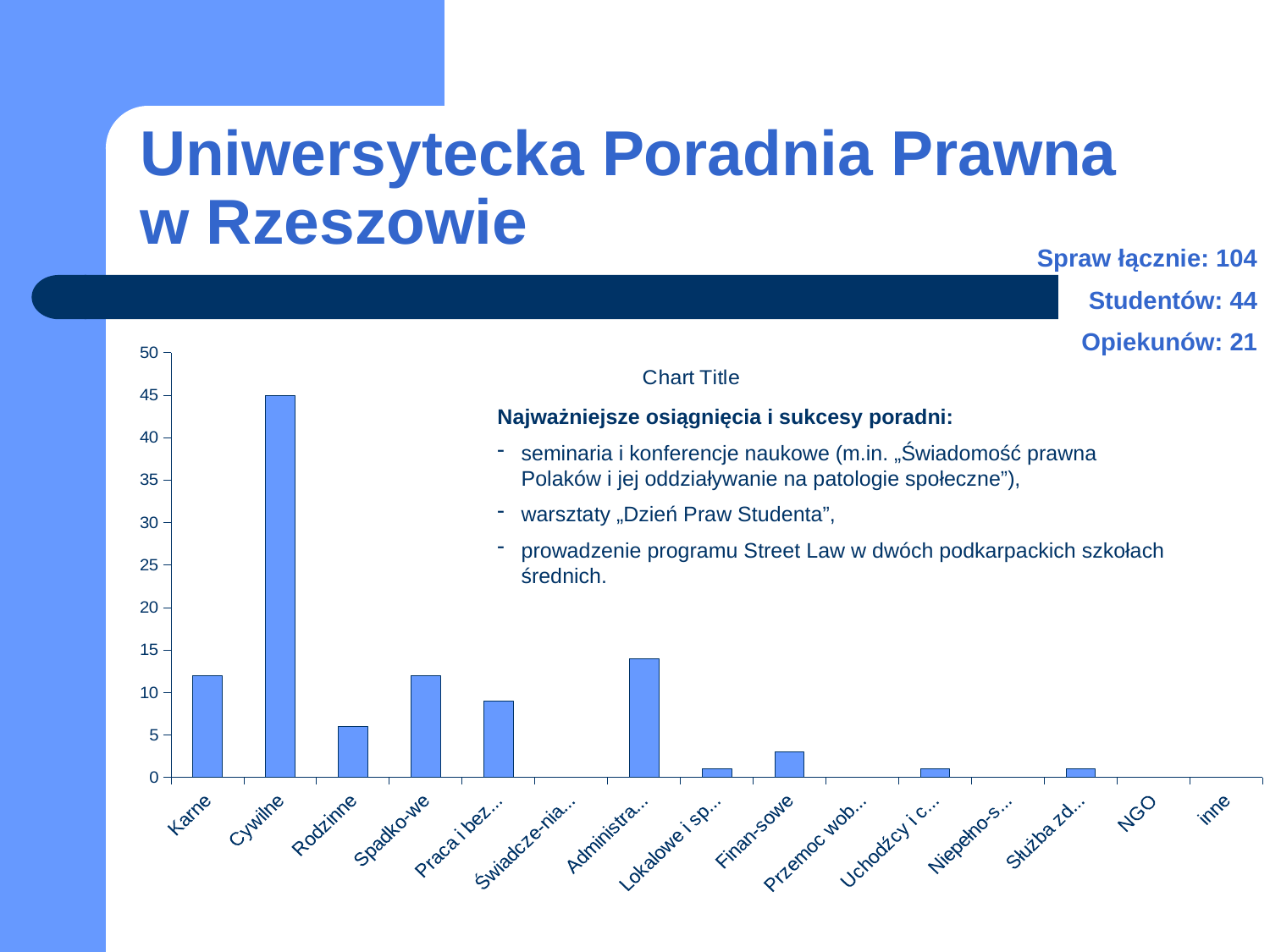
What is the title shown on the chart? Chart Title Which has a larger value, Karne or Rodzinne? Karne What type of chart is shown on the slide? bar chart Is the value for Finan-sowe greater or less than 5? less Is the value for Rodzinne greater or less than 10? less How many categories are shown on the x axis of the chart? 15 Is the value for Praca i bez... greater or less than 10? less Which category has the highest value in the chart? Cywilne Which has a larger value, Cywilne or Administra...? Cywilne